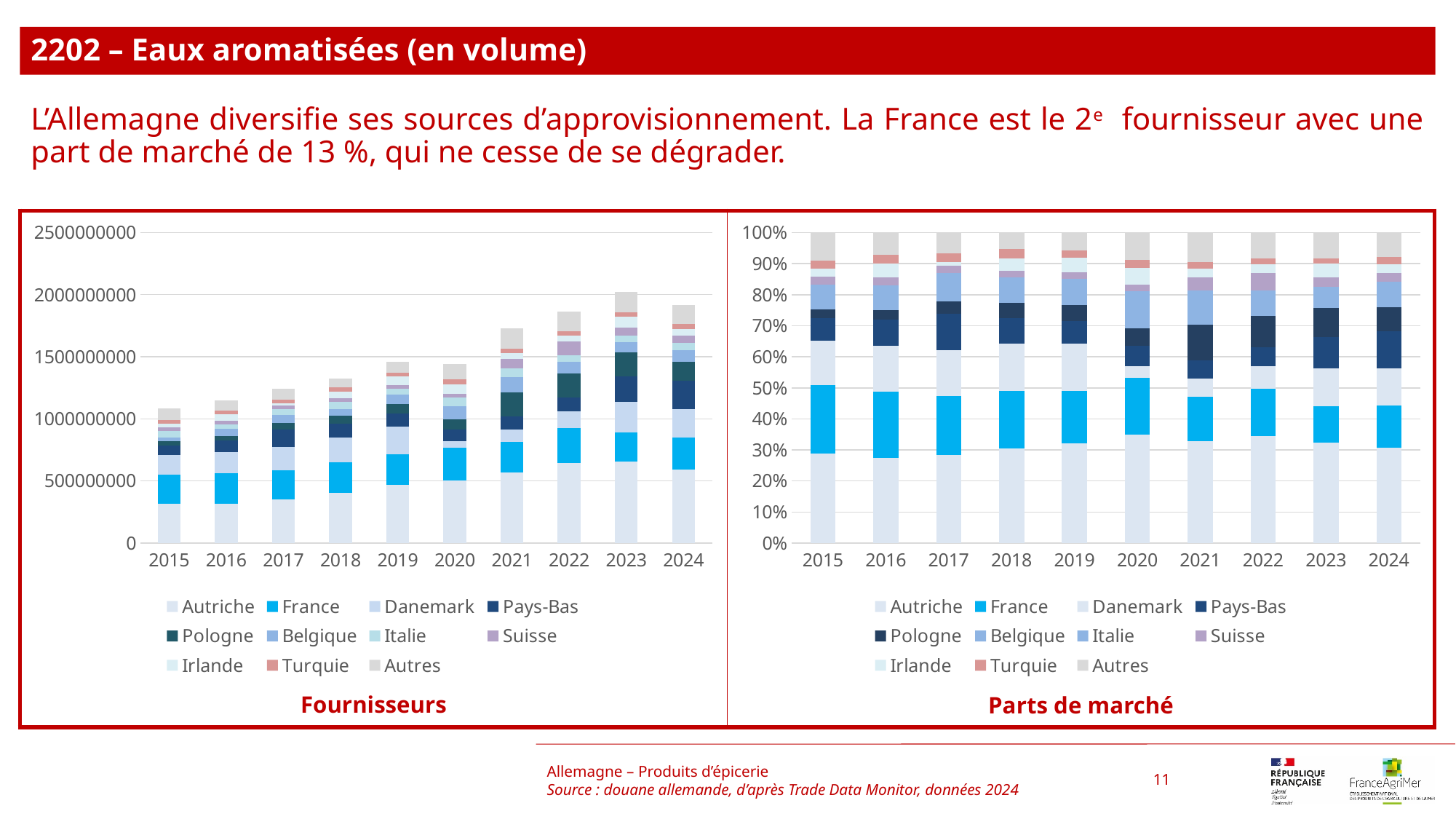
How many series does the legend of the 'Fournisseurs' chart list? 11 What is the title shown under the right-hand chart? Parts de marché In the 'Fournisseurs' chart, is the total for 2021 greater or less than 1500000000? greater In the 'Fournisseurs' chart, which year has the highest total stacked bar? 2023 In the 'Fournisseurs' chart, which year has the lowest total stacked bar? 2015 In the 'Parts de marché' chart, is the share of France in 2024 greater or less than 20%? less What kind of chart is the 'Fournisseurs' chart on the left? Stacked bar chart In the 'Fournisseurs' chart, is the total for 2024 greater or less than 2000000000? less In the 'Fournisseurs' chart, do the total bars rise or fall from 2015 to 2019? rise In the 'Fournisseurs' chart, is the total for 2022 larger than the total for 2021? Yes How many years are shown on the x axis of the 'Parts de marché' chart? 10